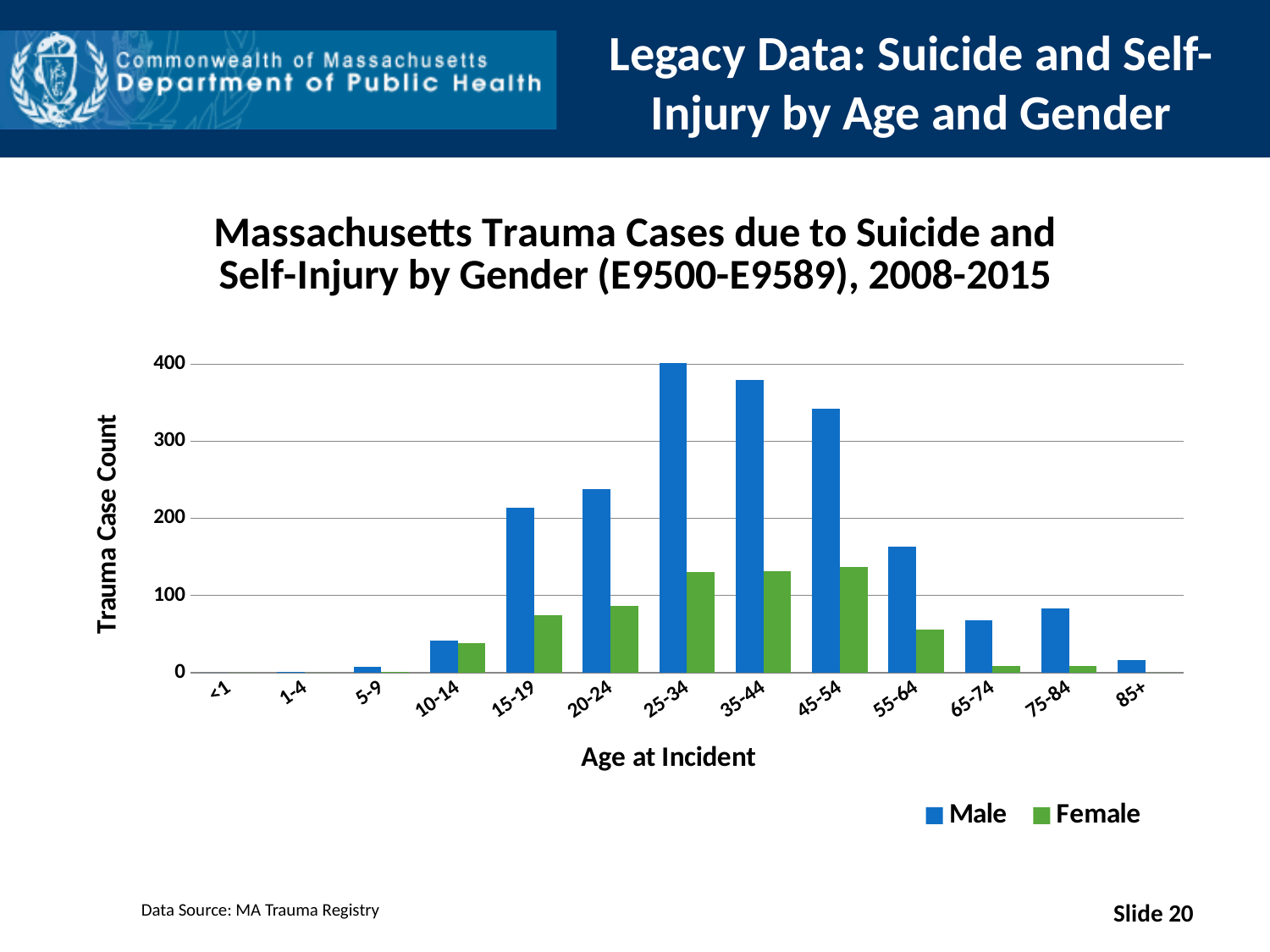
What kind of chart is shown on the slide? bar chart Is the Male value for the 25-34 age group greater or less than 300? greater Is the Male value for the 45-54 age group greater or less than 300? greater Is the Male value for the 65-74 age group greater or less than 100? less Which is larger, the Male value for 35-44 or the Male value for 45-54? 35-44 For the 25-34 age group, which is larger, the Male or the Female value? Male Do the Male values rise or fall from the 25-34 age group to the 85+ age group? fall How many age categories are shown on the x axis? 13 How many series does the legend list? 2 Which age group has the highest Male trauma case count? 25-34